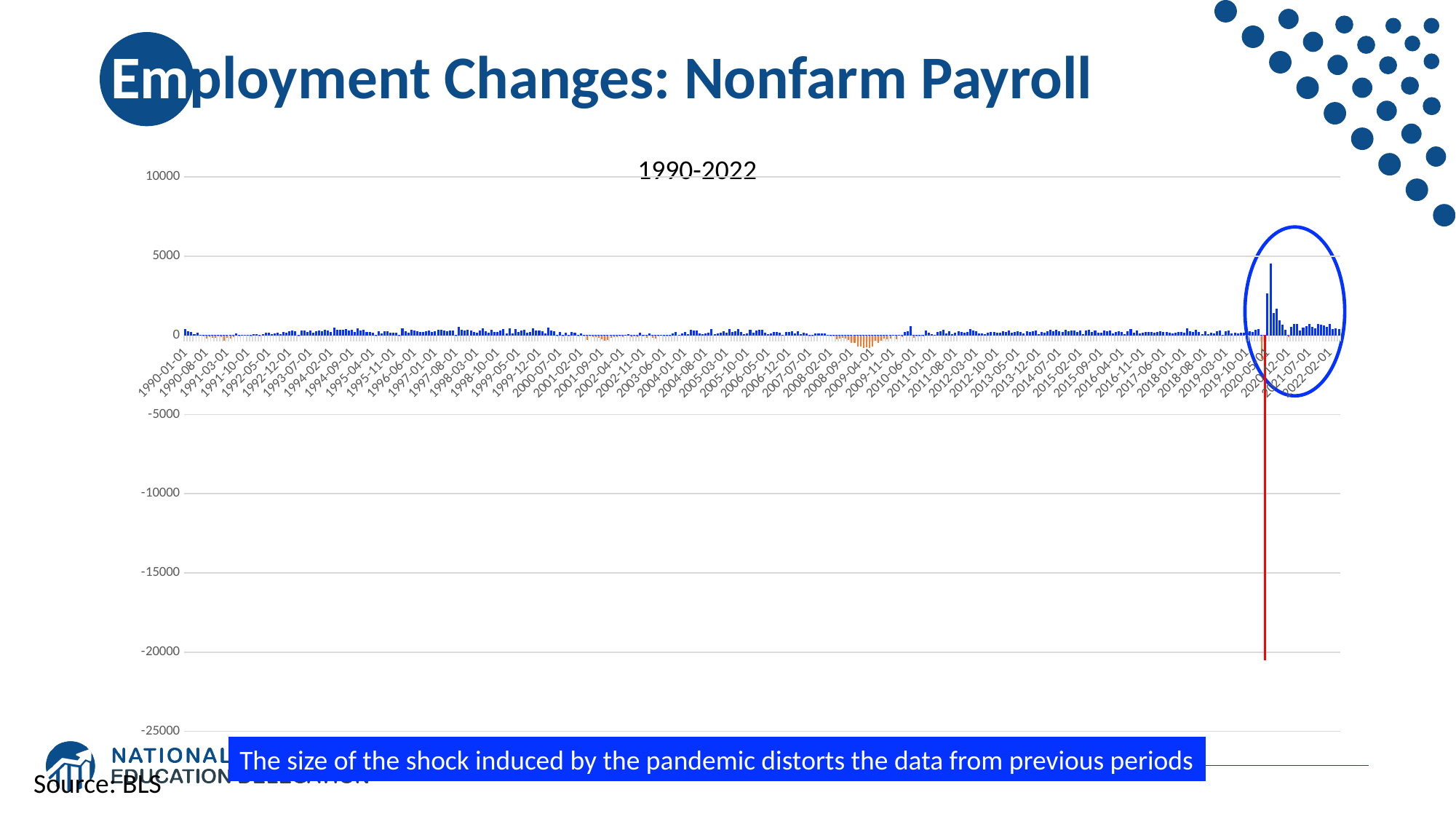
Which is larger in magnitude: the largest negative bar in 2020 or the largest negative bar in 2009? the 2020 bar What is the lowest value shown on the vertical axis? -25000 What kind of chart is shown on the slide? bar chart What is the title shown above the chart's plot area? 1990-2022 In which year does the highest value on the chart occur? 2020 Is the highest value on the chart (the tallest blue bar in 2020) greater or less than 0? greater Is the highest value on the chart (the tallest blue bar in 2020) greater or less than 5000? less Is the lowest value on the chart (the large red bar in 2020) greater or less than -10000? less In which year does the lowest value on the chart occur? 2020